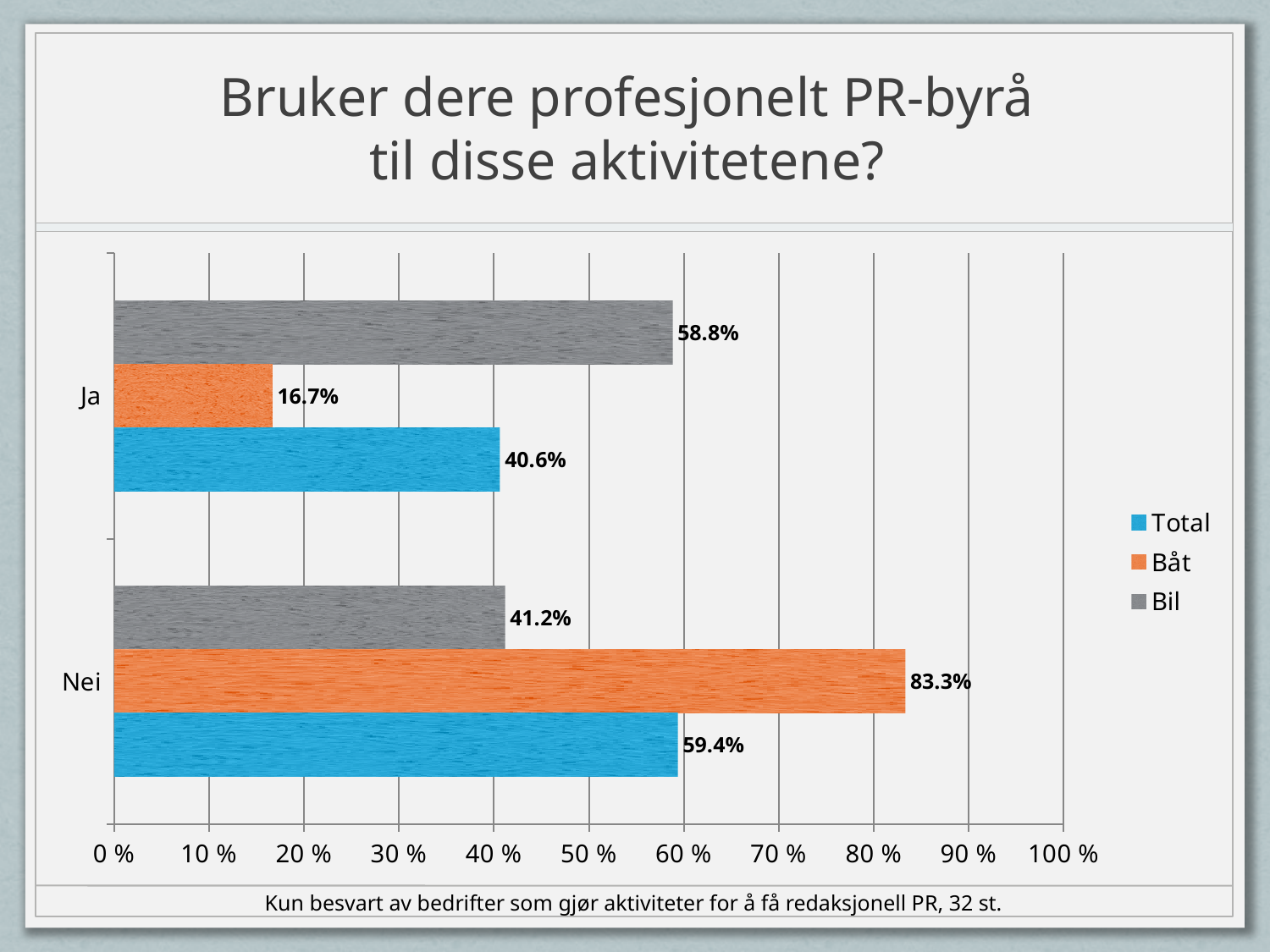
What is the value for Bil in the Ja category? 58.8% How many categories are shown on the vertical axis? 2 Which is larger: the Total value for Ja or the Total value for Nei? Nei Which series has the highest value in the Nei category? Båt What is the value for Båt in the Nei category? 83.3% What colour represents the Båt series? orange What type of chart is shown on the slide? bar chart What is the difference between the Båt and Bil values in the Nei category? 42.1% Which series has the lowest value in the Ja category? Båt Is the value for Bil in the Nei category greater or less than 50 %? less How many series does the legend list? 3 What is the value for Total in the Ja category? 40.6%